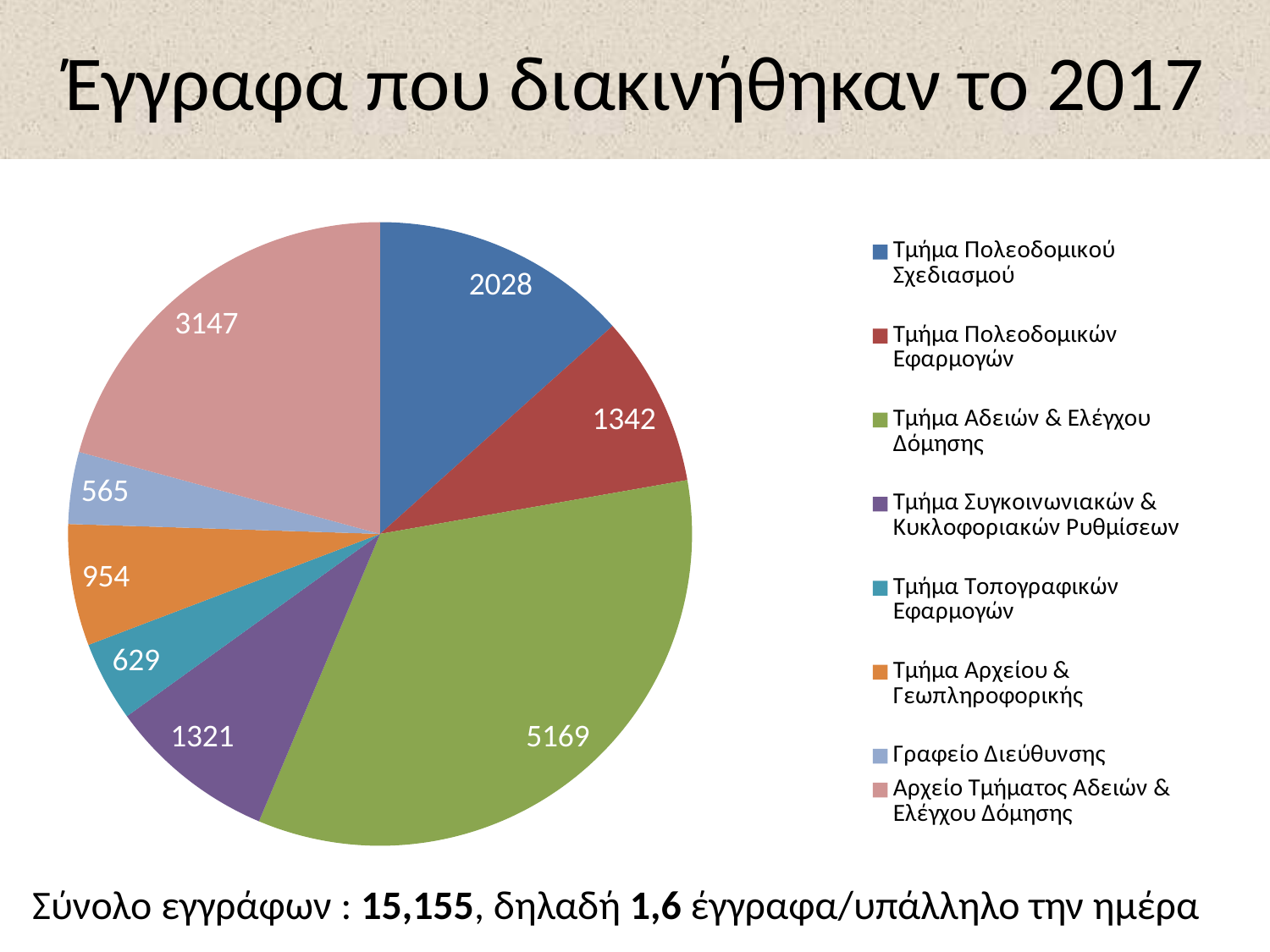
What is the value for Γραφείο Διεύθυνσης? 565 What colour is the slice for Τμήμα Συγκοινωνιακών & Κυκλοφοριακών Ρυθμίσεων? purple What is the total of all the values in the pie chart? 15,155 What is the value for Τμήμα Αδειών & Ελέγχου Δόμησης? 5169 Which category has the smallest slice of the pie? Γραφείο Διεύθυνσης Which is larger, the value for Τμήμα Αρχείου & Γεωπληροφορικής or the value for Τμήμα Τοπογραφικών Εφαρμογών? Τμήμα Αρχείου & Γεωπληροφορικής What is the difference between the values for Τμήμα Αδειών & Ελέγχου Δόμησης and Αρχείο Τμήματος Αδειών & Ελέγχου Δόμησης? 2022 How many slices does the pie chart have? 8 Which category has the largest slice of the pie? Τμήμα Αδειών & Ελέγχου Δόμησης What is the value for Τμήμα Πολεοδομικού Σχεδιασμού? 2028 What type of chart is shown on the slide? pie chart What is the value for Αρχείο Τμήματος Αδειών & Ελέγχου Δόμησης? 3147